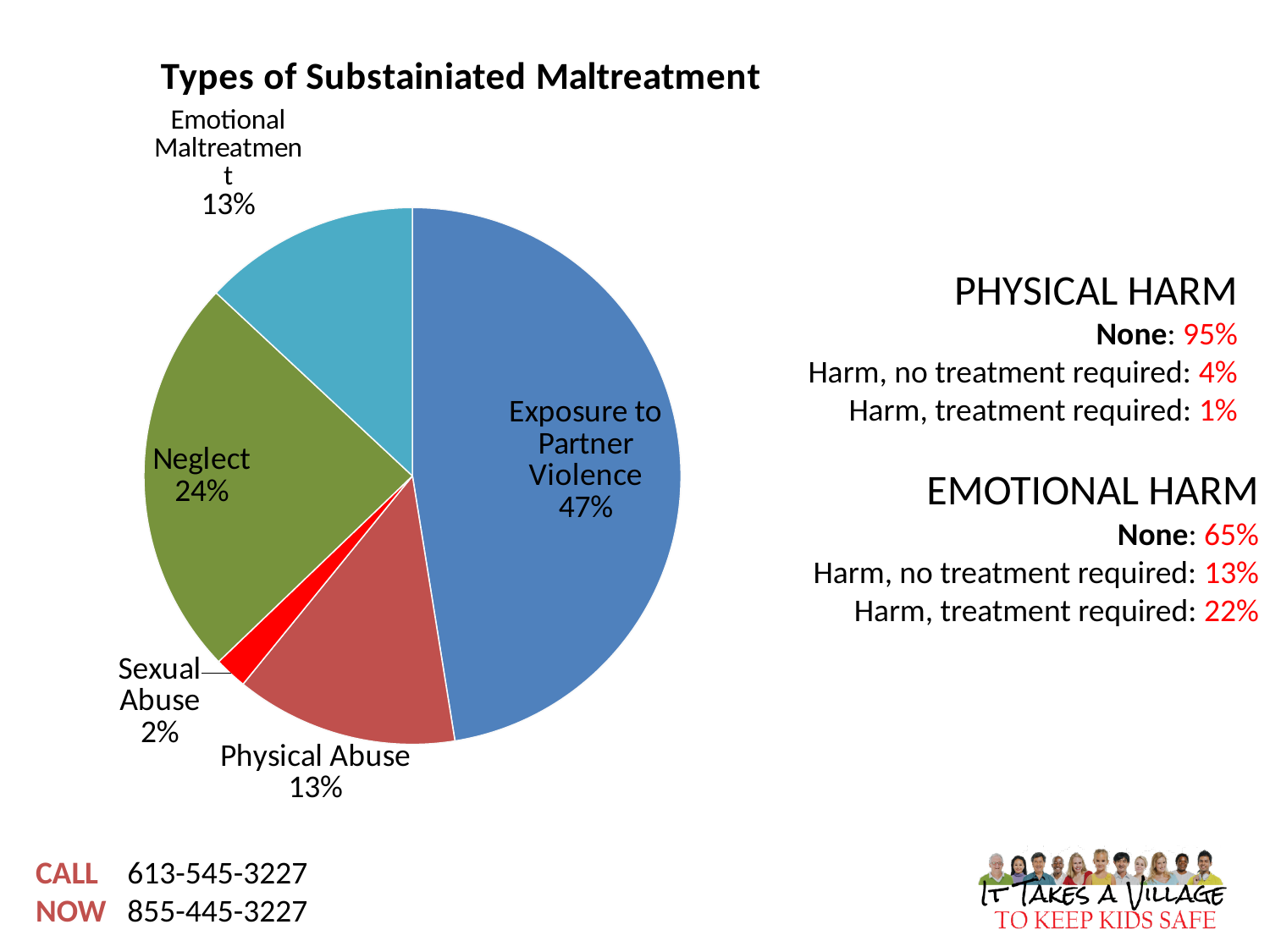
What colour is the Sexual Abuse slice? Red What percentage of the pie is Exposure to Partner Violence? 47% Which is larger, the share for Neglect or the share for Physical Abuse? Neglect Which category has the largest share of the pie? Exposure to Partner Violence What is the difference in percentage points between Exposure to Partner Violence and Neglect? 23 What percentage of the pie is Neglect? 24% What is the title of the chart? Types of Substainiated Maltreatment What percentage of the pie is Physical Abuse? 13% What type of chart is shown on the slide? Pie chart What percentage of the pie is Sexual Abuse? 2% How many categories are shown in the pie chart? 5 Which category has the smallest share of the pie? Sexual Abuse